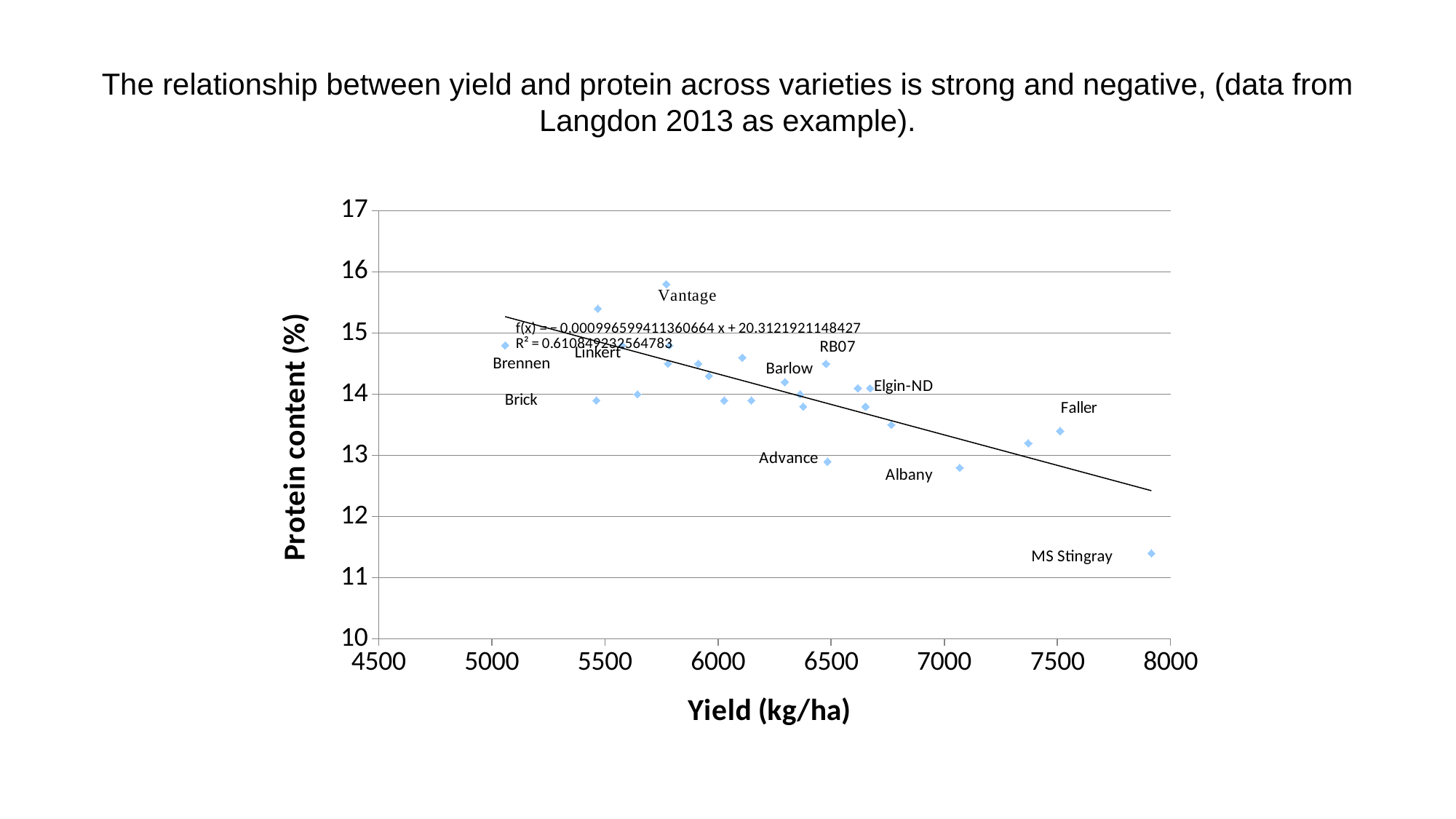
Is the protein content for MS Stingray greater or less than 12? less Is the yield for Elgin-ND greater or less than 6500? greater What is the title of the x axis? Yield (kg/ha) Is the yield for MS Stingray greater or less than 7500? greater Does protein content rise or fall as yield increases along the x axis? fall What kind of chart is shown on the slide? scatter chart Which has the higher protein content, Vantage or MS Stingray? Vantage Which labelled variety has the highest protein content? Vantage What R² value is printed on the chart? 0.610849232564783 Which labelled variety has the lowest protein content? MS Stingray